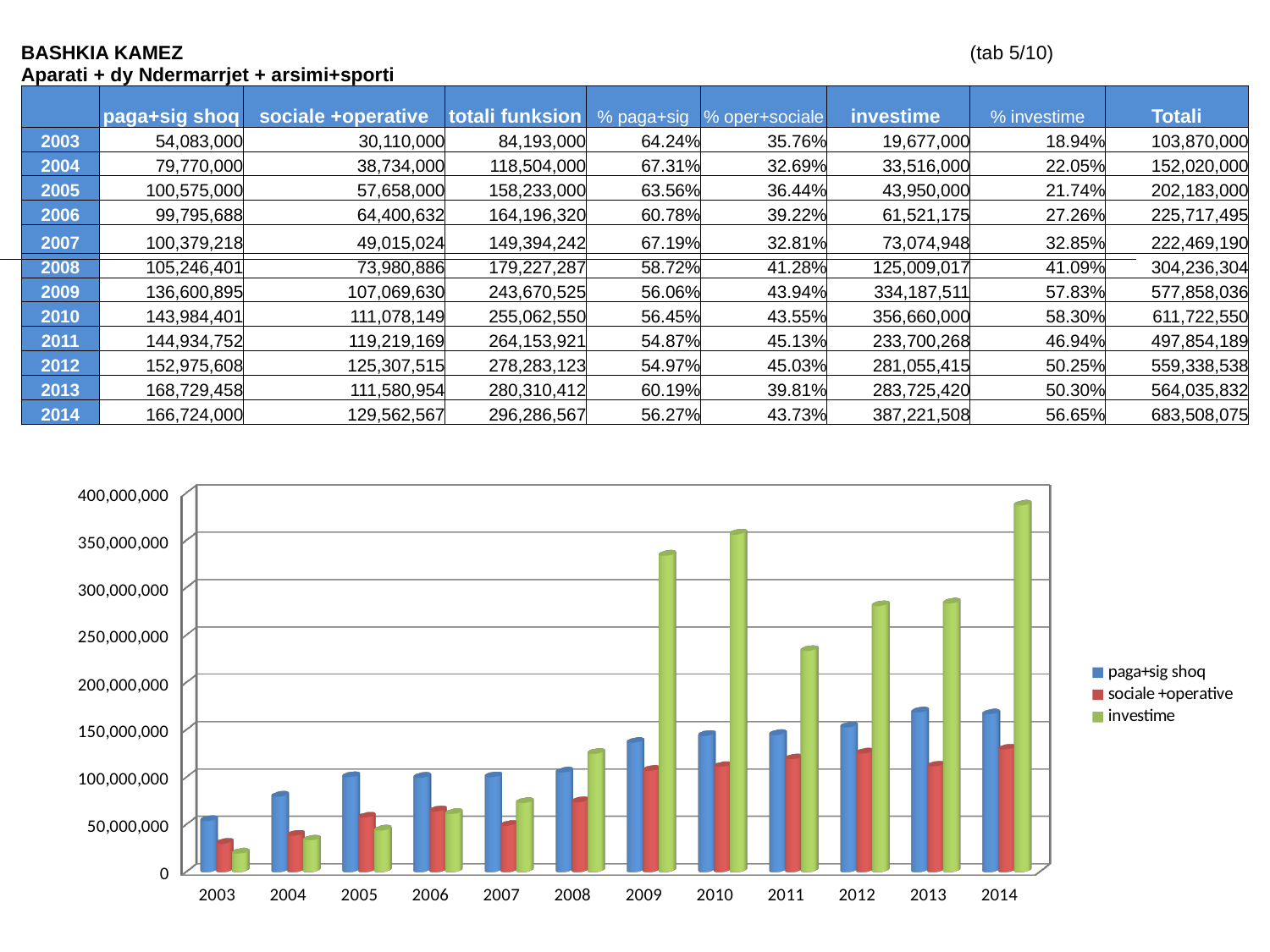
Does the paga+sig shoq series generally rise or fall from 2003 to 2014? rise How many series does the chart's legend list? 3 How many years are shown along the x axis of the chart? 12 Which is larger, the investime value for 2010 or for 2011? 2010 In which year is the investime bar the lowest? 2003 What is the investime value for 2014? 387,221,508 What colour represents investime in the chart's legend? green Is the paga+sig shoq value for 2003 greater or less than 100,000,000? less Is the investime value for 2009 greater or less than 300,000,000? greater What kind of chart is shown on the slide? bar chart What is the difference between paga+sig shoq and sociale +operative in 2014? 37,161,433 In which year is the investime bar the highest? 2014